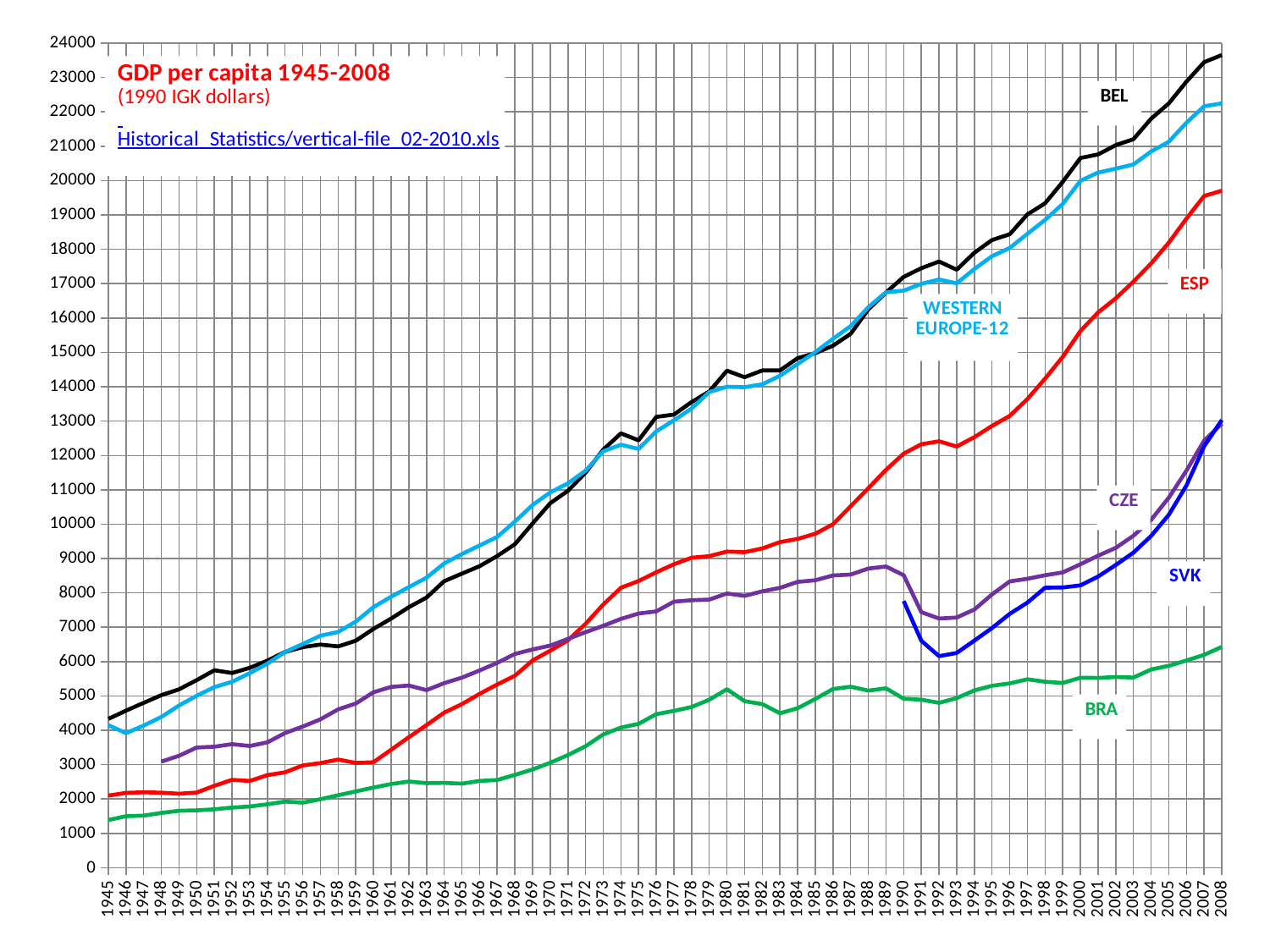
Which series has the lowest value in 2008? BRA Which is larger in 2008, the value for ESP or the value for CZE? ESP What kind of chart is shown on the slide? line chart How many years are shown along the x axis of the chart? 64 Which series has the lowest value in 1945? BRA In what units are the values on the chart expressed, according to the subtitle? 1990 IGK dollars Does the value for BRA generally rise or fall from 1945 to 2008? rise What is the title of the chart? GDP per capita 1945-2008 How many series (countries or regions) are plotted on the chart? 6 Is the value for ESP in 2008 greater or less than 20000? less Which series has the highest value in 2008? BEL Is the value for BEL in 2008 greater or less than 23000? greater